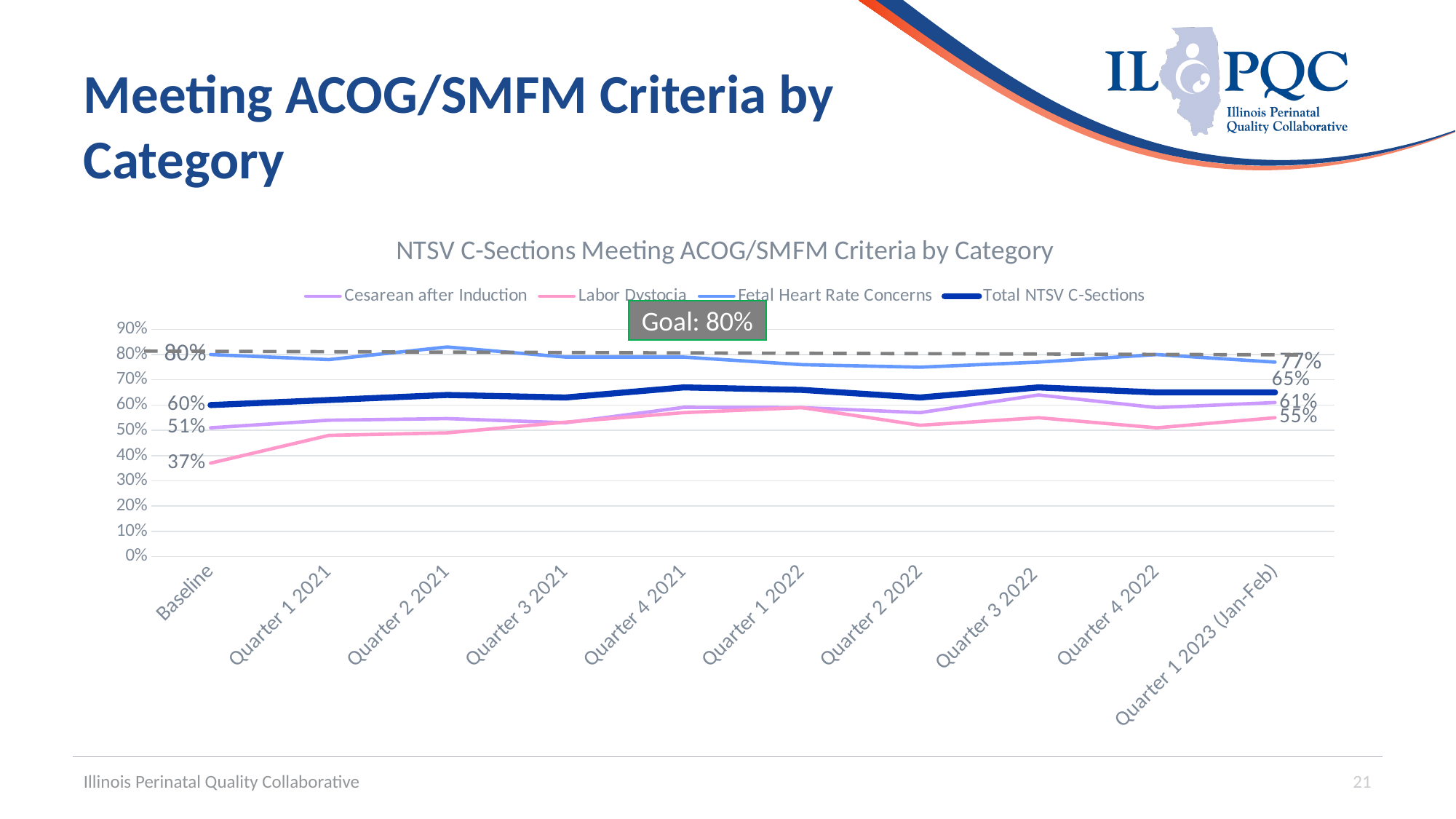
What is the Cesarean after Induction value at Quarter 1 2023 (Jan-Feb)? 61% Which series has the highest value at Quarter 1 2023 (Jan-Feb)? Fetal Heart Rate Concerns Which series has the lowest value at Baseline? Labor Dystocia How many series does the chart legend list? 4 What is the Fetal Heart Rate Concerns value at Baseline? 80% What type of chart is shown on the slide? Line chart Does the Total NTSV C-Sections line rise or fall from Baseline to Quarter 1 2023 (Jan-Feb)? Rise What is the Labor Dystocia value at Baseline? 37% What is the title of the chart? NTSV C-Sections Meeting ACOG/SMFM Criteria by Category What is the Total NTSV C-Sections value at Quarter 1 2023 (Jan-Feb)? 65% How many time periods are shown along the x axis? 10 By how many percentage points did Labor Dystocia change from Baseline (37%) to Quarter 1 2023 (Jan-Feb) (55%)? 18 percentage points